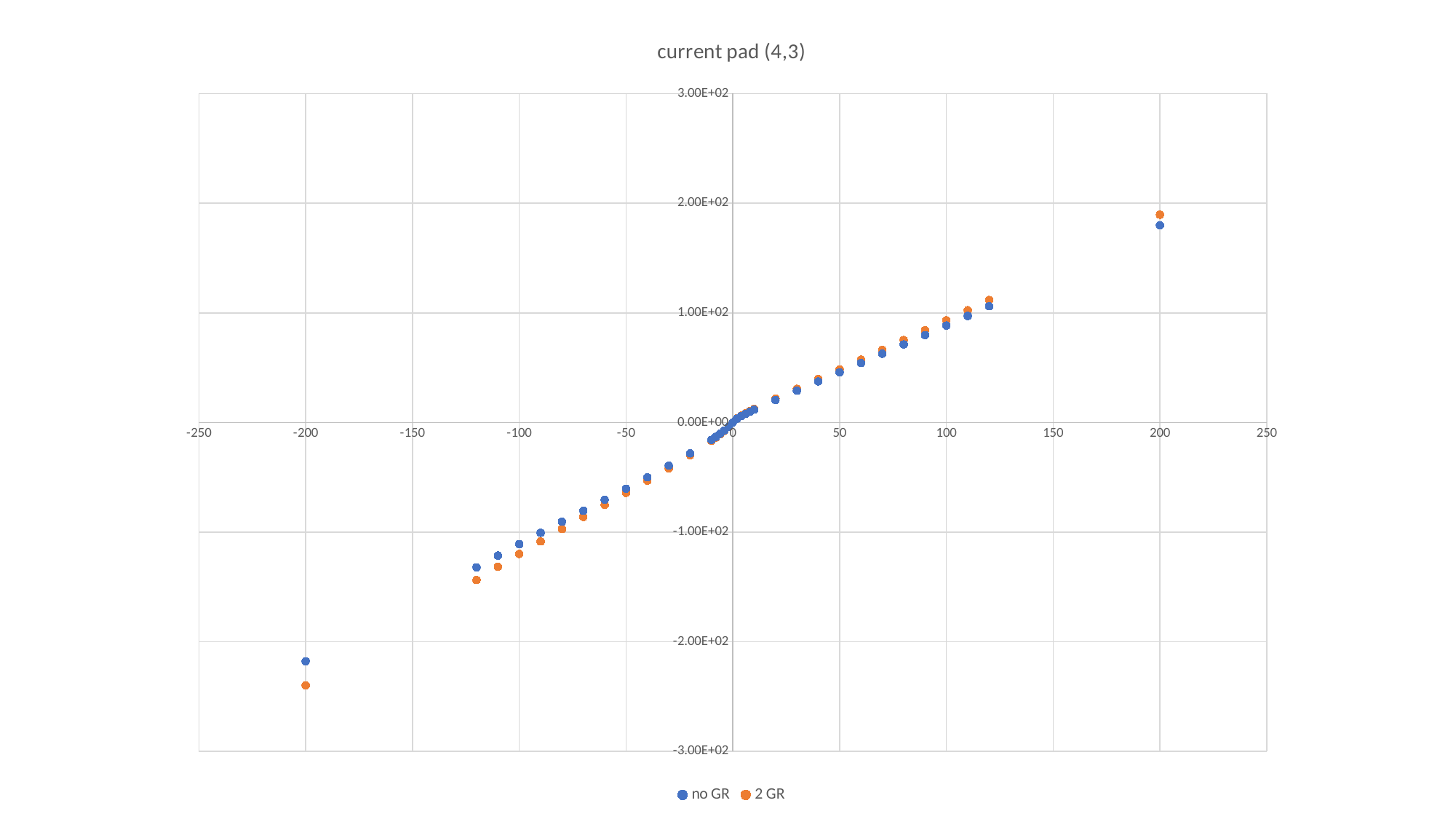
What kind of chart is shown on the slide? scatter chart Do the plotted values rise or fall as the x axis increases? rise How many series does the legend list? 2 Which series is plotted in orange? 2 GR Is the value of the no GR series at x = 100 greater or less than 1.00E+02? less What is the title of the chart? current pad (4,3) At x = 200, which series has the larger value, no GR or 2 GR? 2 GR At which x value does the no GR series reach its highest point? 200 Is the value of the 2 GR series at x = -200 greater or less than -2.00E+02? less Is the value of the no GR series at x = 200 greater or less than 1.00E+02? greater At x = -200, which series has the lower value, no GR or 2 GR? 2 GR